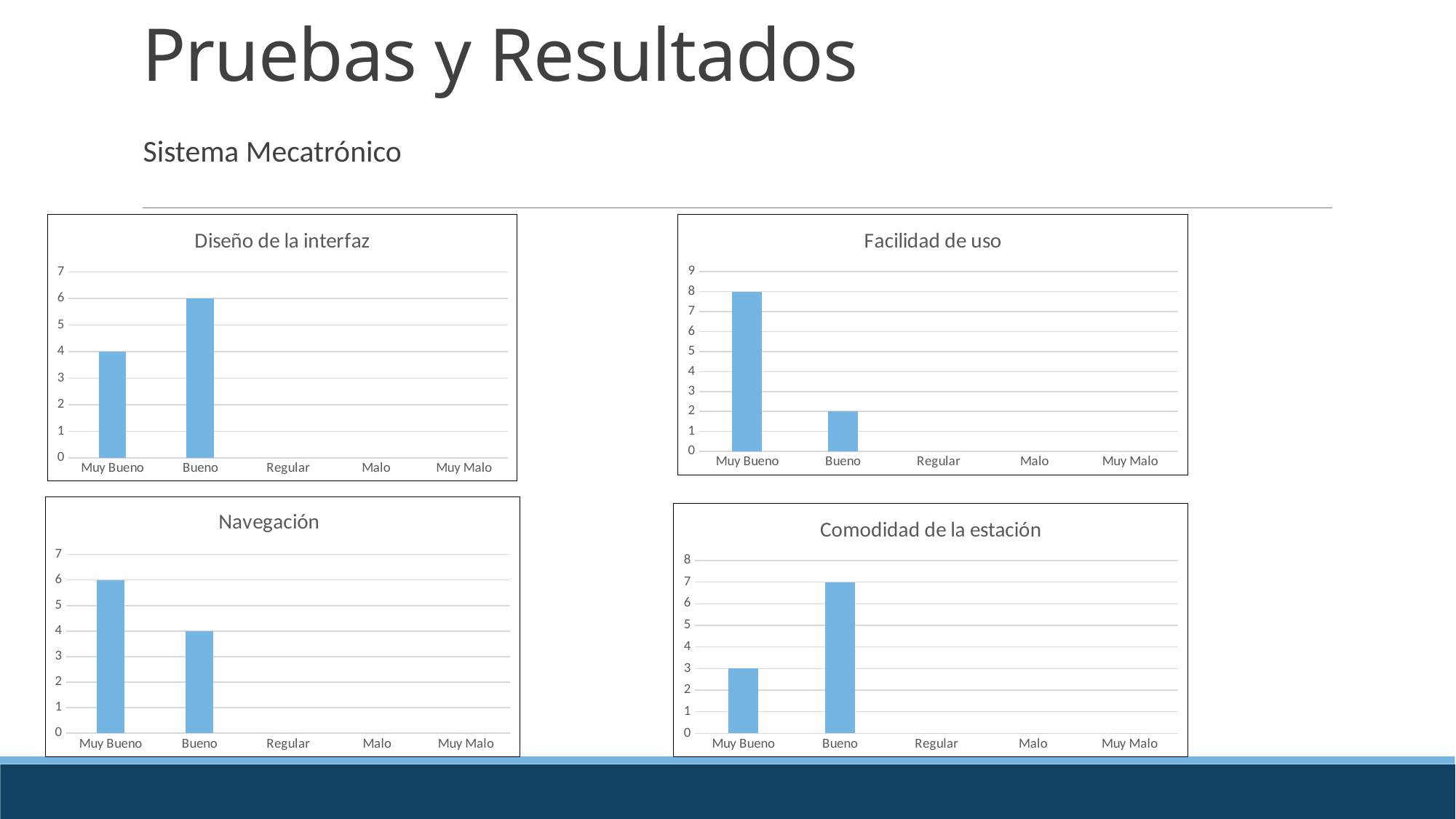
In the 'Diseño de la interfaz' chart, what is the total of Muy Bueno and Bueno? 10 In the 'Diseño de la interfaz' chart, what is the value for Bueno? 6 In the 'Comodidad de la estación' chart, is the value for Bueno greater or less than 5? greater In the 'Navegación' chart, what is the value for Bueno? 4 In the 'Facilidad de uso' chart, what is the difference between Muy Bueno and Bueno? 6 What is the title of the chart in the bottom-left of the slide? Navegación In the 'Facilidad de uso' chart, what is the value for Muy Bueno? 8 How many categories are shown on the x axis of the 'Navegación' chart? 5 In the 'Comodidad de la estación' chart, what is the value for Muy Bueno? 3 What kind of chart is 'Facilidad de uso'? Bar chart In the 'Navegación' chart, which is larger, Muy Bueno or Bueno? Muy Bueno In the 'Diseño de la interfaz' chart, which category has the highest value? Bueno